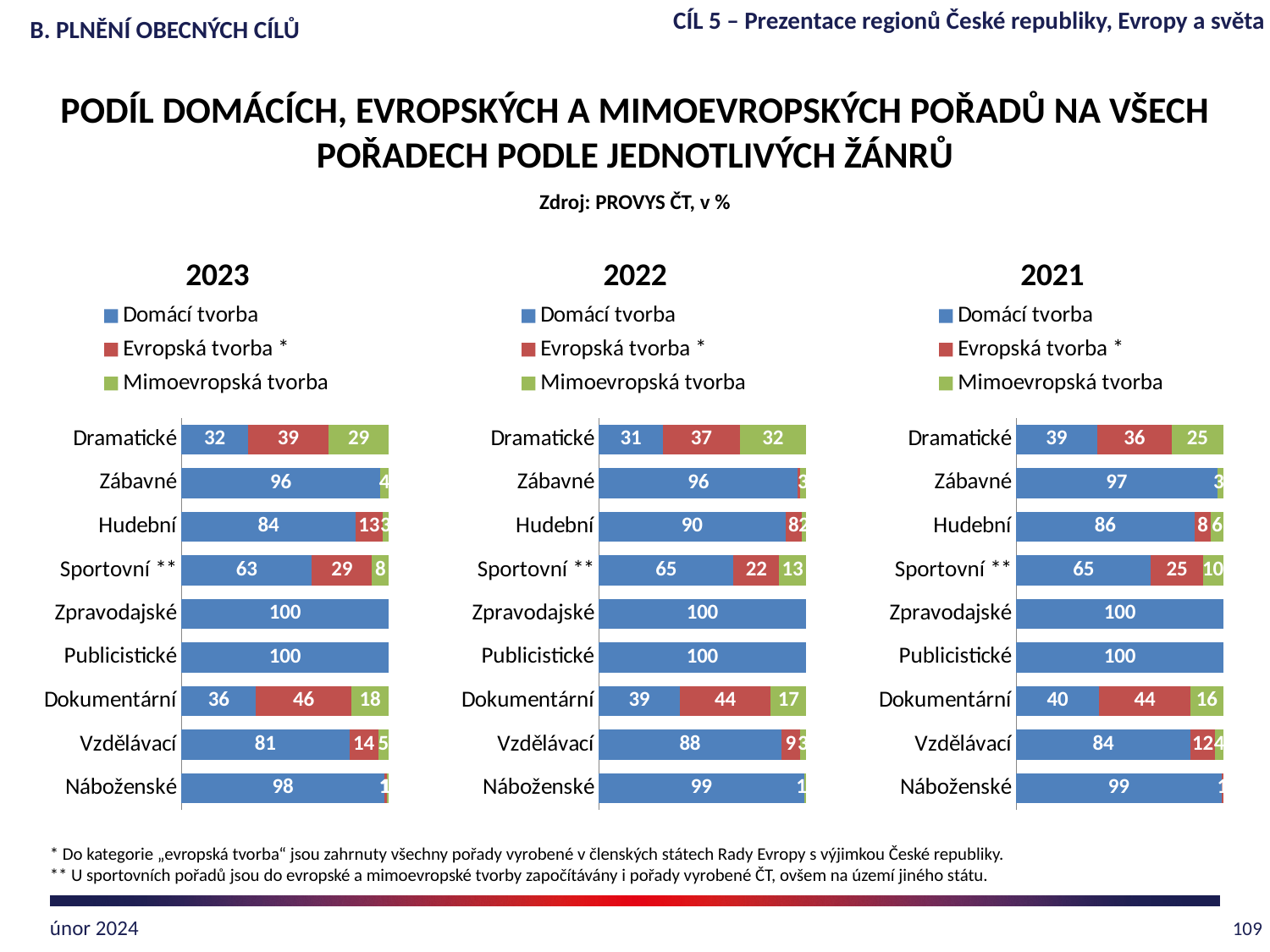
In the 2022 chart, what is the value of Domácí tvorba for Sportovní **? 65 How many categories are shown in the 2022 chart? 9 In the 2022 chart, which category has the highest value of Evropská tvorba *? Dokumentární In the 2023 chart, what is the value of Domácí tvorba for Dramatické? 32 What type of chart is the 2023 chart? Stacked bar chart In the 2021 chart, what is the difference between the Domácí tvorba values for Hudební and Vzdělávací? 2 How many series does the legend of the 2021 chart list? 3 In the 2023 chart, which category has the lowest value of Domácí tvorba? Dramatické What is the source stated below the slide title? PROVYS ČT, v % In the 2021 chart, what is the value of Mimoevropská tvorba for Sportovní **? 10 In the 2022 chart, what is the value of Evropská tvorba * for Dokumentární? 44 In the 2023 chart, which is larger for Dokumentární: Domácí tvorba or Evropská tvorba *? Evropská tvorba *